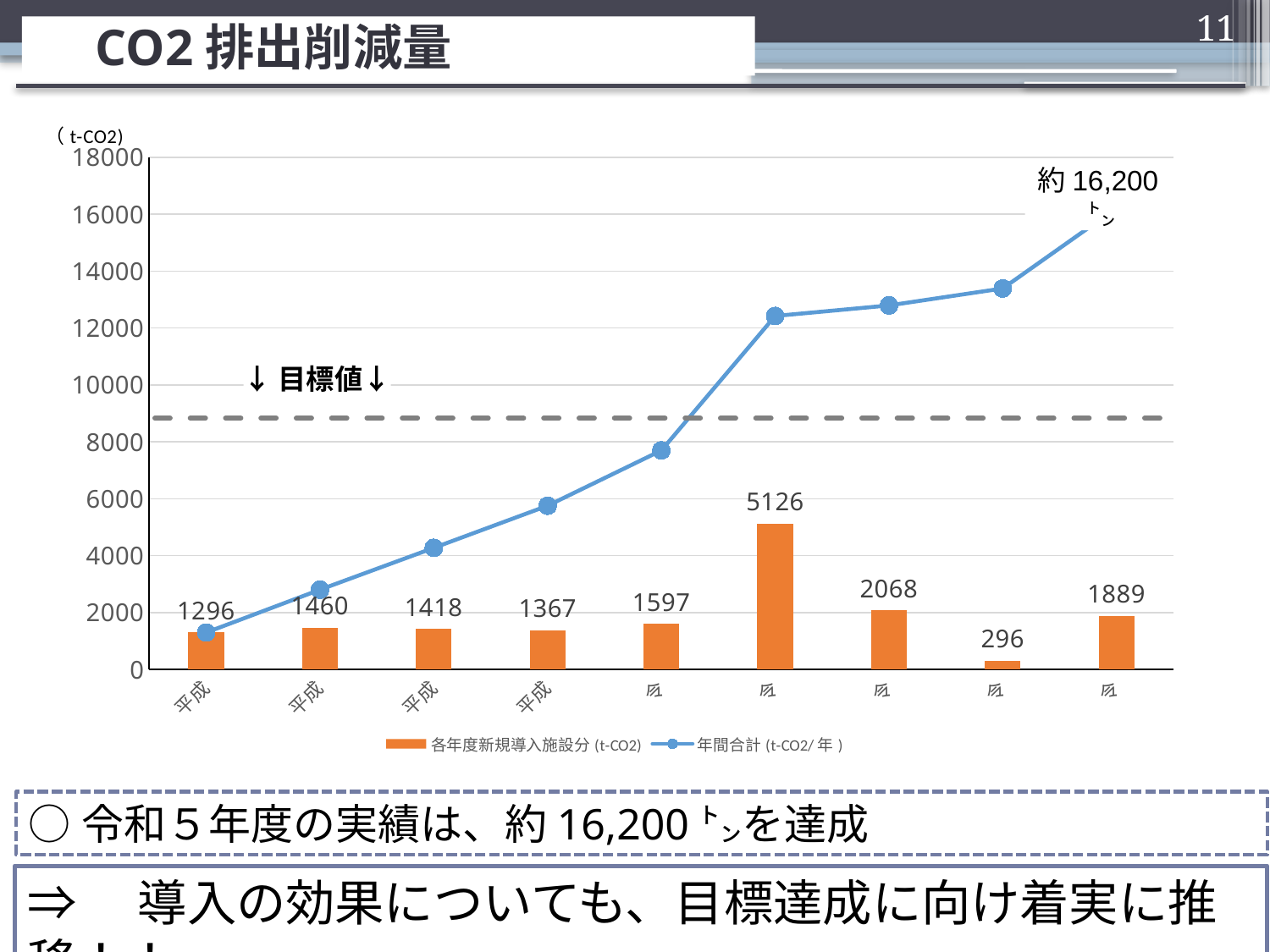
How many series does the legend list? 2 Is the value of the 年間合計 line at the sixth point greater or less than 12000? greater Does the 年間合計 line rise or fall from left to right? rises What is the value of the highest orange bar (各年度新規導入施設分)? 5126 Is the value of the 年間合計 line at the fifth point greater or less than 8000? less What is the value of the lowest orange bar (各年度新規導入施設分)? 296 What is the value of the first (leftmost) orange bar? 1296 How many orange bars are plotted in the chart? 9 What is the difference between the highest orange bar (5126) and the seventh bar (2068)? 3058 What is the value of the seventh orange bar from the left? 2068 Which is larger, the second orange bar (1460) or the third orange bar (1418)? 1460 What is the value of the last (rightmost) orange bar? 1889